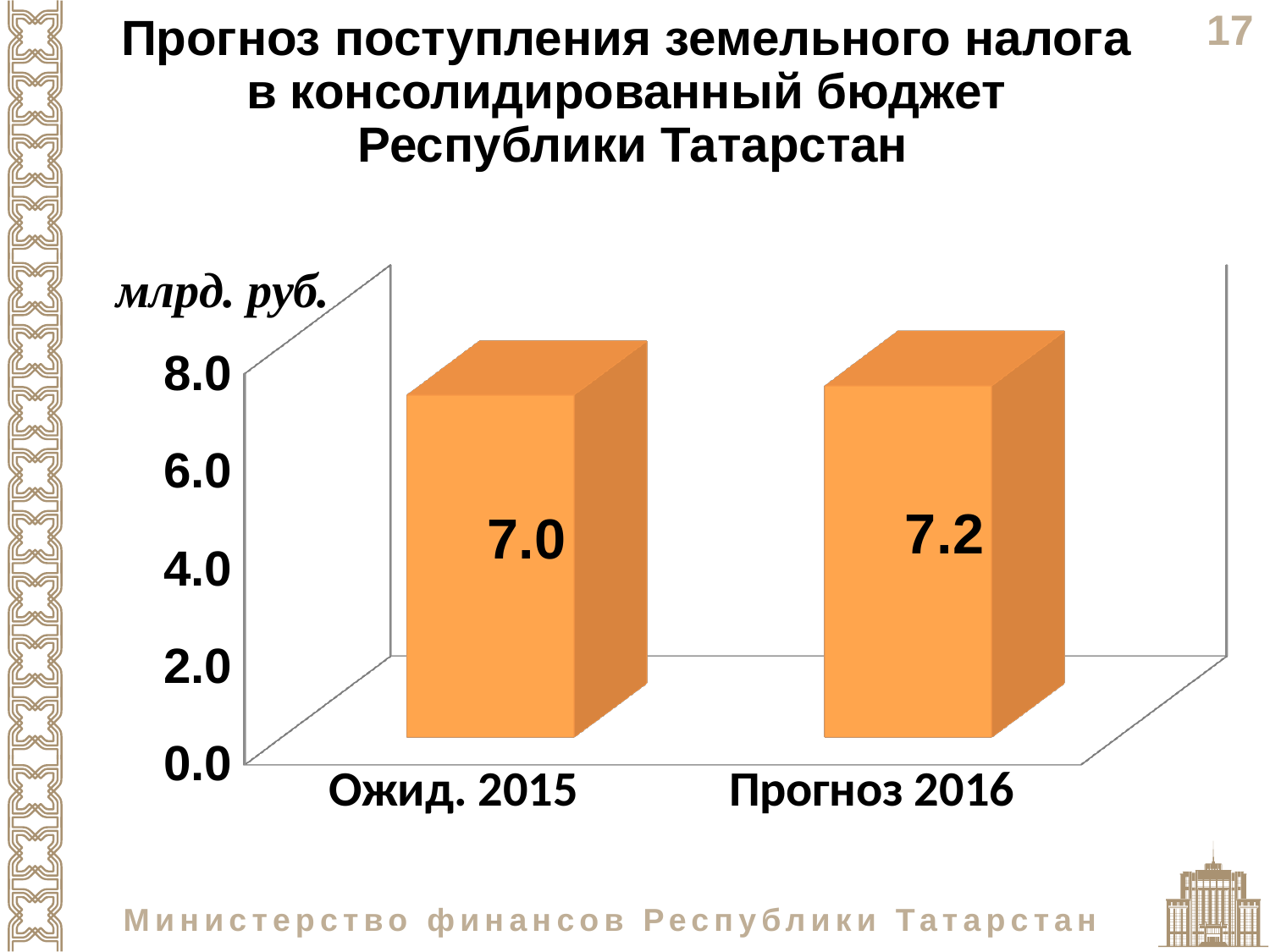
What is the value for Прогноз 2016? 7.2 How many categories are shown on the x axis? 2 Which category has the highest value? Прогноз 2016 Is the value for Прогноз 2016 greater or less than 8.0? less Is the value for Ожид. 2015 greater or less than 6.0? greater What is the difference between the values for Прогноз 2016 and Ожид. 2015? 0.2 What unit is shown for the values on the chart? млрд. руб. Which category has the lowest value? Ожид. 2015 What kind of chart is shown on the slide? bar chart Which is larger, the value for Ожид. 2015 or the value for Прогноз 2016? Прогноз 2016 Do the values rise or fall from Ожид. 2015 to Прогноз 2016? rise What is the value for Ожид. 2015? 7.0